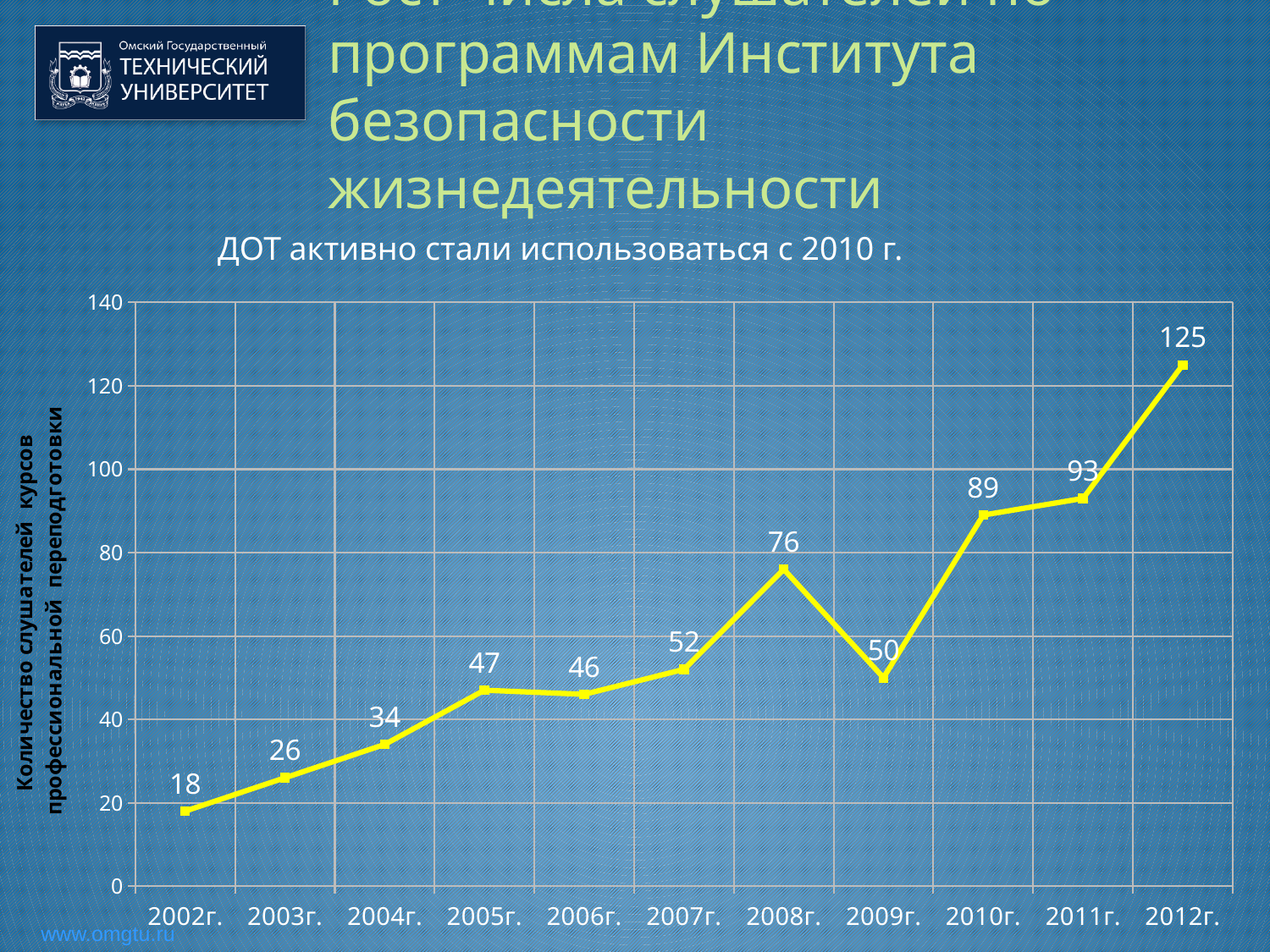
What is the difference between the values for 2008г. and 2009г.? 26 Which year has the highest value? 2012г. What is the value for 2008г.? 76 Does the value rise or fall from 2008г. to 2009г.? fall What is the difference between the values for 2012г. and 2010г.? 36 Which is larger, the value for 2005г. or the value for 2006г.? 2005г. What is the label on the vertical axis? Количество слушателей курсов профессиональной переподготовки What is the value for 2011г.? 93 How many years are plotted on the x axis? 11 What type of chart is shown on the slide? line chart Which year has the lowest value? 2002г. What is the value for 2002г.? 18